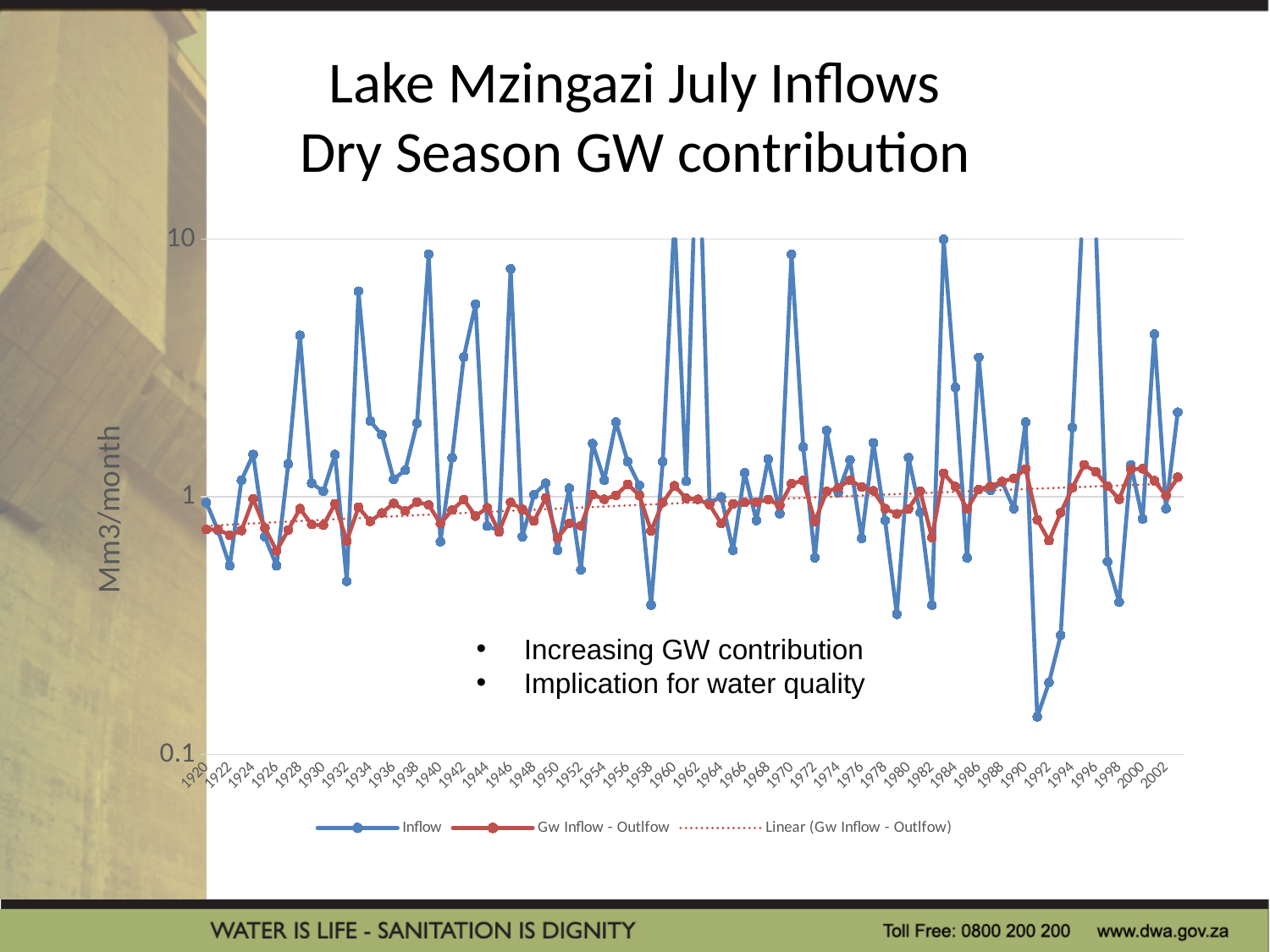
In 1939, which series has the larger value, Inflow or Gw Inflow - Outlfow? Inflow Is the Inflow value for 1939 greater or less than 1? greater What is the label on the vertical axis of the chart? Mm3/month Does the Linear (Gw Inflow - Outlfow) trendline rise or fall from 1920 to 2002? rise How many series does the chart legend list? 3 What kind of chart is shown on the slide? Line chart Is the Inflow value for 1958 greater or less than 1? less Is the Inflow value for 1992 greater or less than 1? less In 1992, which series has the larger value, Inflow or Gw Inflow - Outlfow? Gw Inflow - Outlfow What is the title of the chart on the slide? Lake Mzingazi July Inflows Dry Season GW contribution